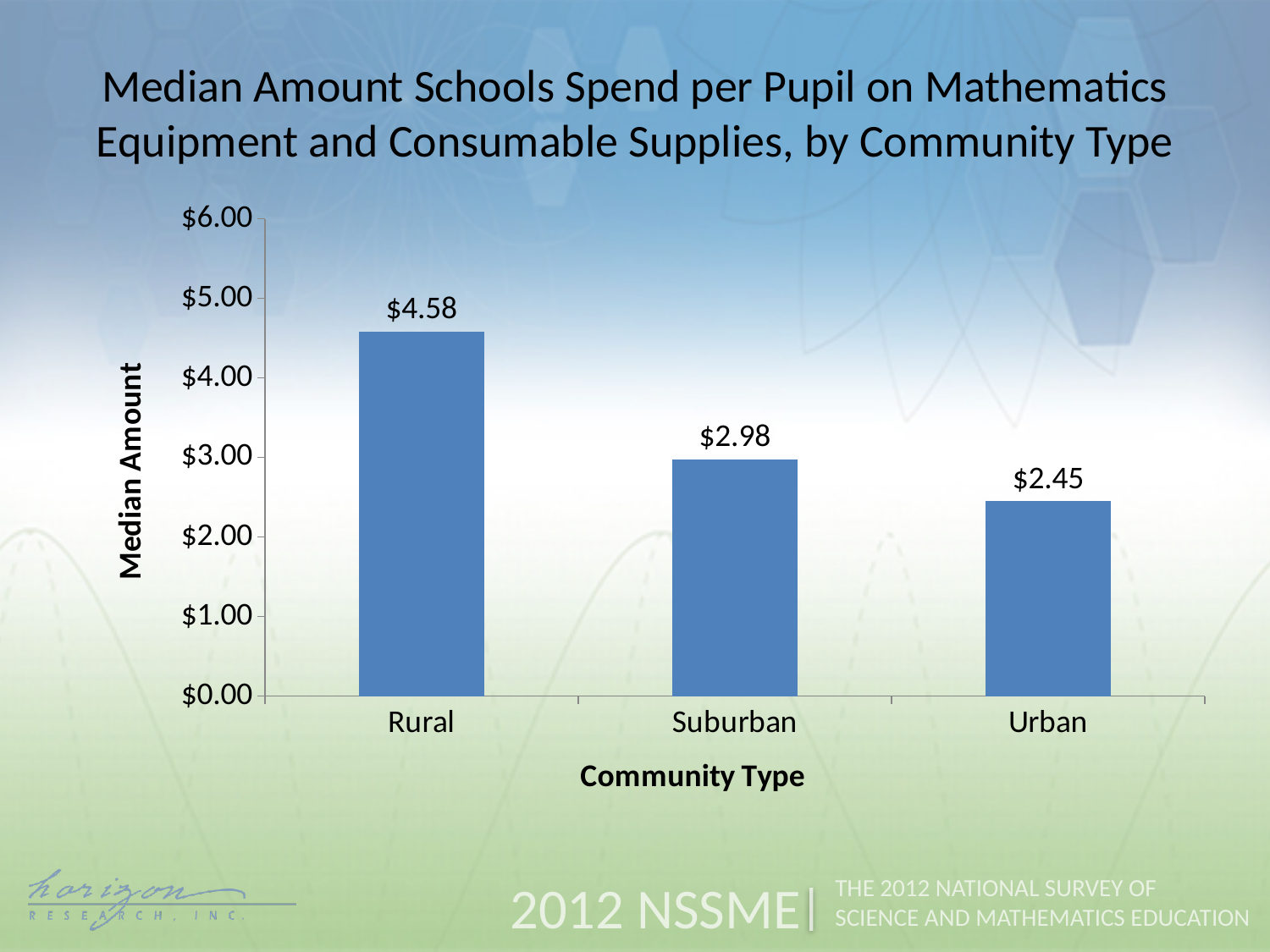
What is the median amount spent per pupil for Suburban schools? $2.98 Which community type has the lowest median amount? Urban Which is larger, the median amount for Suburban or for Urban? Suburban Which community type has the highest median amount? Rural What is the median amount spent per pupil for Urban schools? $2.45 What is the difference between the Suburban and Urban median amounts? $0.53 Do the values rise or fall from Rural to Urban along the x axis? fall What is the median amount spent per pupil for Rural schools? $4.58 What kind of chart is shown on the slide? bar chart What is the difference between the Rural and Urban median amounts? $2.13 Is the value for Rural greater or less than $4.00? greater How many community types are shown on the chart? 3